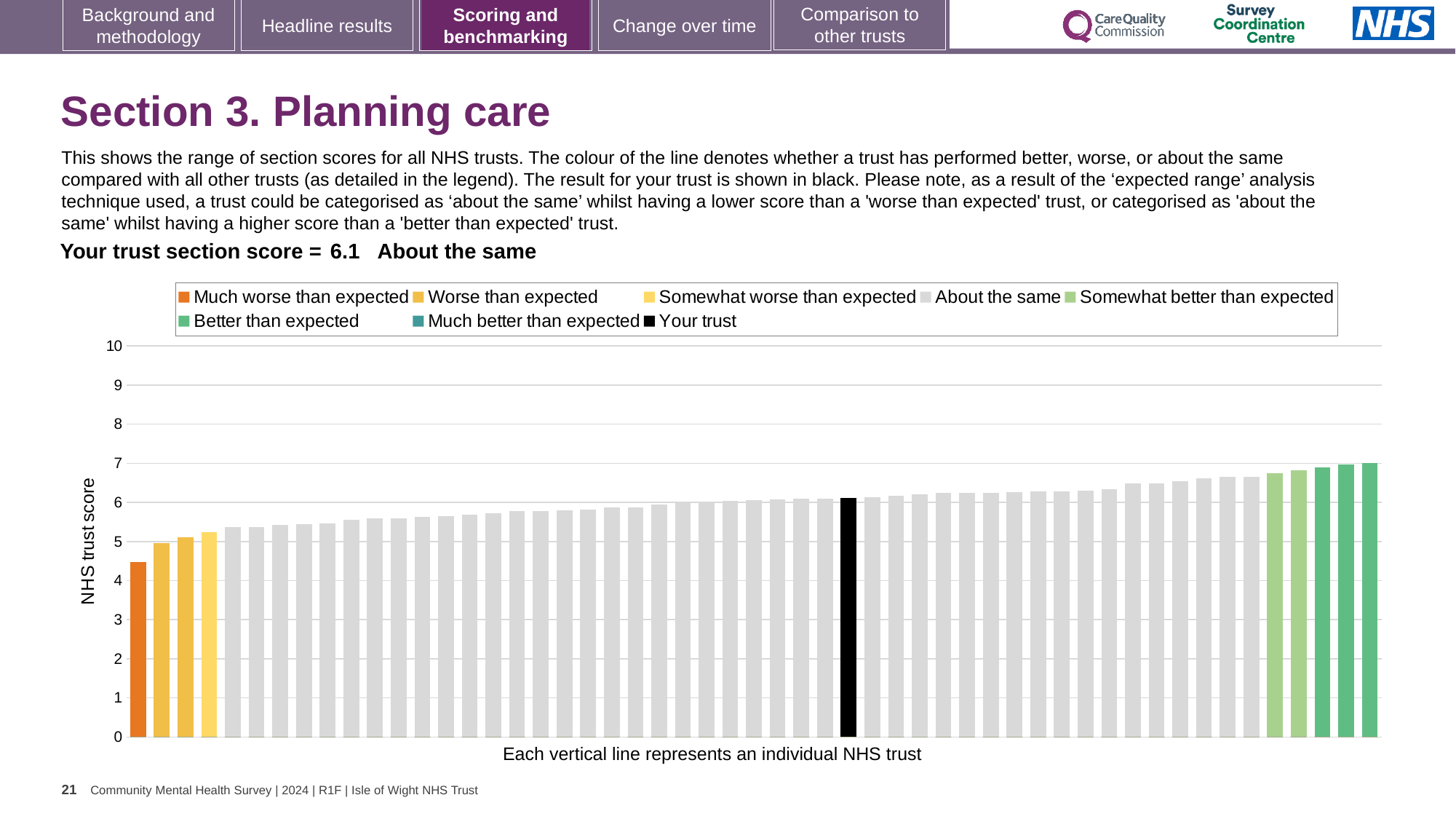
How many entries does the chart legend list? 8 How many bars are coloured orange (Much worse than expected)? 1 What is the section score for your trust shown on the slide? 6.1 Do the bar values rise or fall from left to right along the x axis? rise Is the value of the rightmost bar greater or less than 6? greater Which legend category does the lowest bar on the chart belong to? Much worse than expected Which is larger, the leftmost bar or the rightmost bar? the rightmost bar Is the value of the black 'Your trust' bar greater or less than 5? greater What is the label on the vertical axis of the chart? NHS trust score Is the value of the leftmost (orange) bar greater or less than 5? less What kind of chart is shown on the slide? bar chart What colour is the bar representing your trust? black